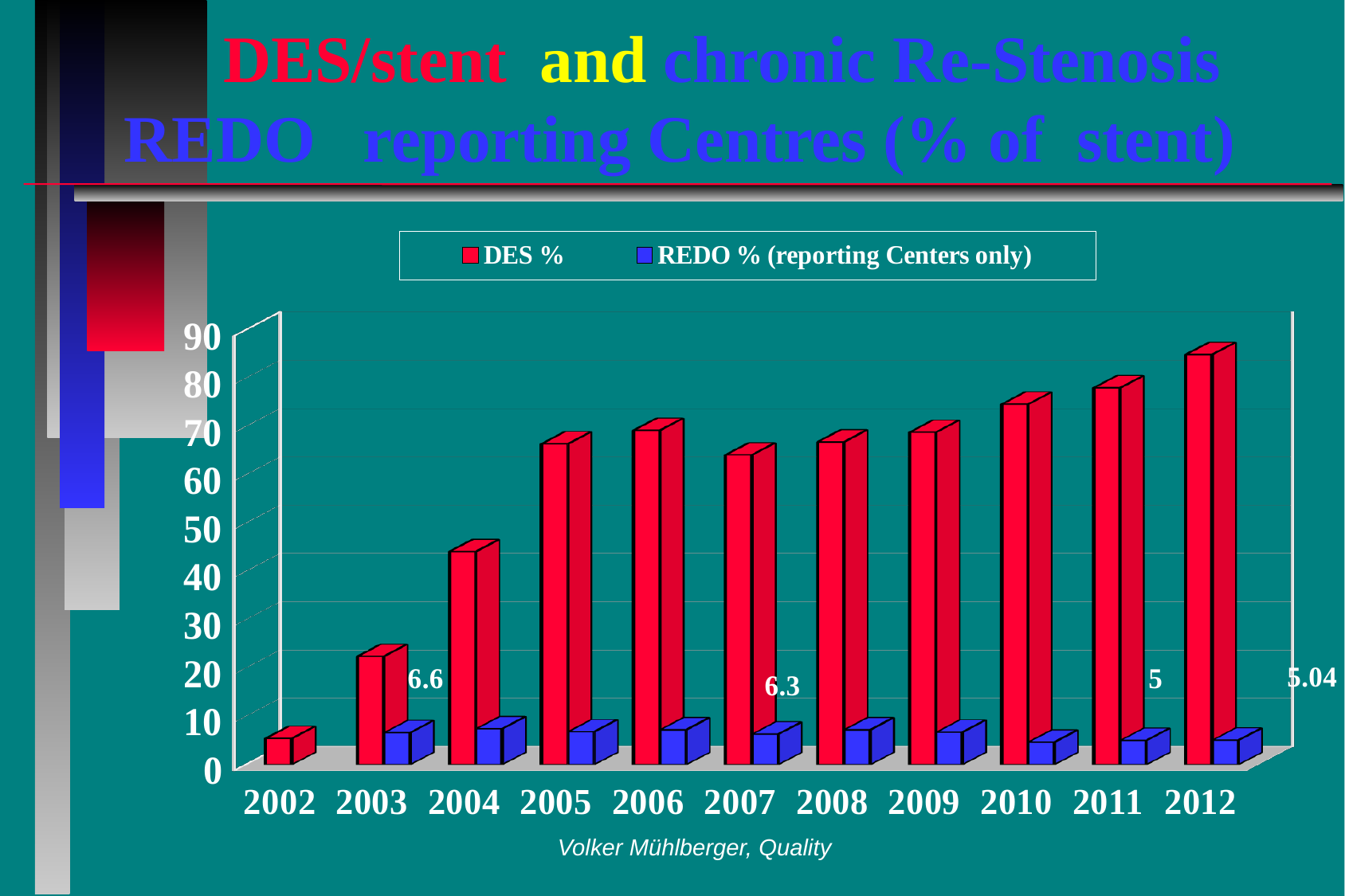
What REDO % value is labelled for 2007? 6.3 Is the DES % value for 2004 greater or less than 50? less Which year has the lowest DES % value? 2002 Which is larger, the DES % value for 2004 or for 2005? 2005 What kind of chart is shown on the slide? bar chart Is the DES % value for 2012 greater or less than 80? greater Does the DES % series generally rise or fall from 2002 to 2012? rise Which year has the highest DES % value? 2012 Is the DES % value for 2002 greater or less than 10? less What colour are the bars for the REDO % (reporting Centers only) series? blue How many series does the legend list? 2 How many years are shown along the x axis? 11